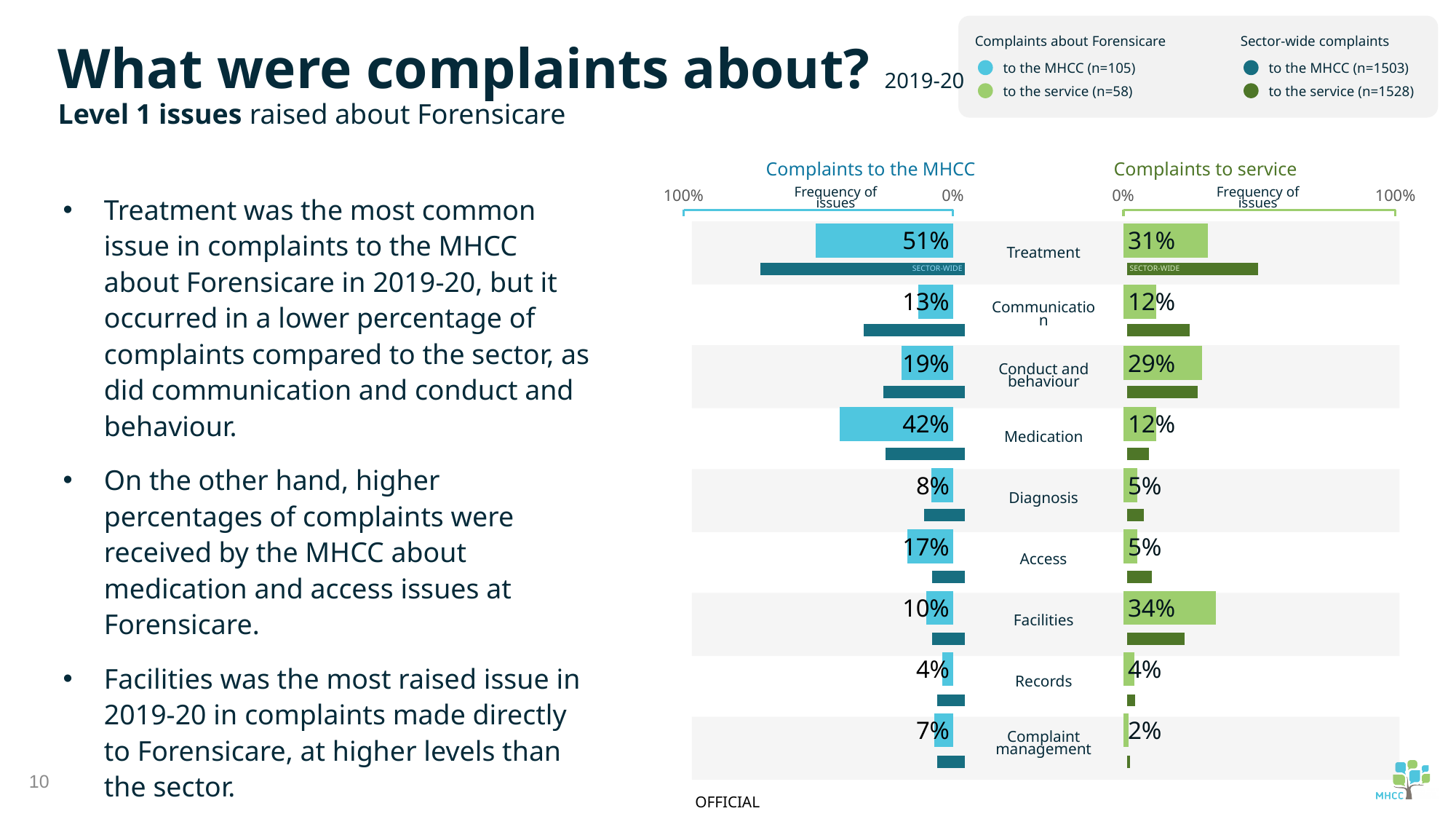
In the 'Complaints to the MHCC' chart, what percentage of Forensicare complaints raised Treatment as an issue? 51% In the 'Complaints to service' chart, what is the Forensicare value for Complaint management? 2% In the 'Complaints to service' chart, what is the difference between the Forensicare values for Facilities and Treatment? 3% How many entries does the legend at the top right of the slide list? 4 In the 'Complaints to service' chart, what percentage of Forensicare complaints raised Facilities as an issue? 34% In the 'Complaints to service' chart, which issue has the highest Forensicare percentage? Facilities Which is larger for Forensicare: the Access value in the 'Complaints to the MHCC' chart or the Access value in the 'Complaints to service' chart? Complaints to the MHCC How many issue categories are listed in the charts? 9 In the 'Complaints to the MHCC' chart, which issue has the highest Forensicare percentage? Treatment In the 'Complaints to the MHCC' chart, which issue has the lowest Forensicare percentage? Records In the 'Complaints to the MHCC' chart, what is the Forensicare value for Medication? 42% In the 'Complaints to the MHCC' chart, what is the difference between the Forensicare values for Treatment and Medication? 9%